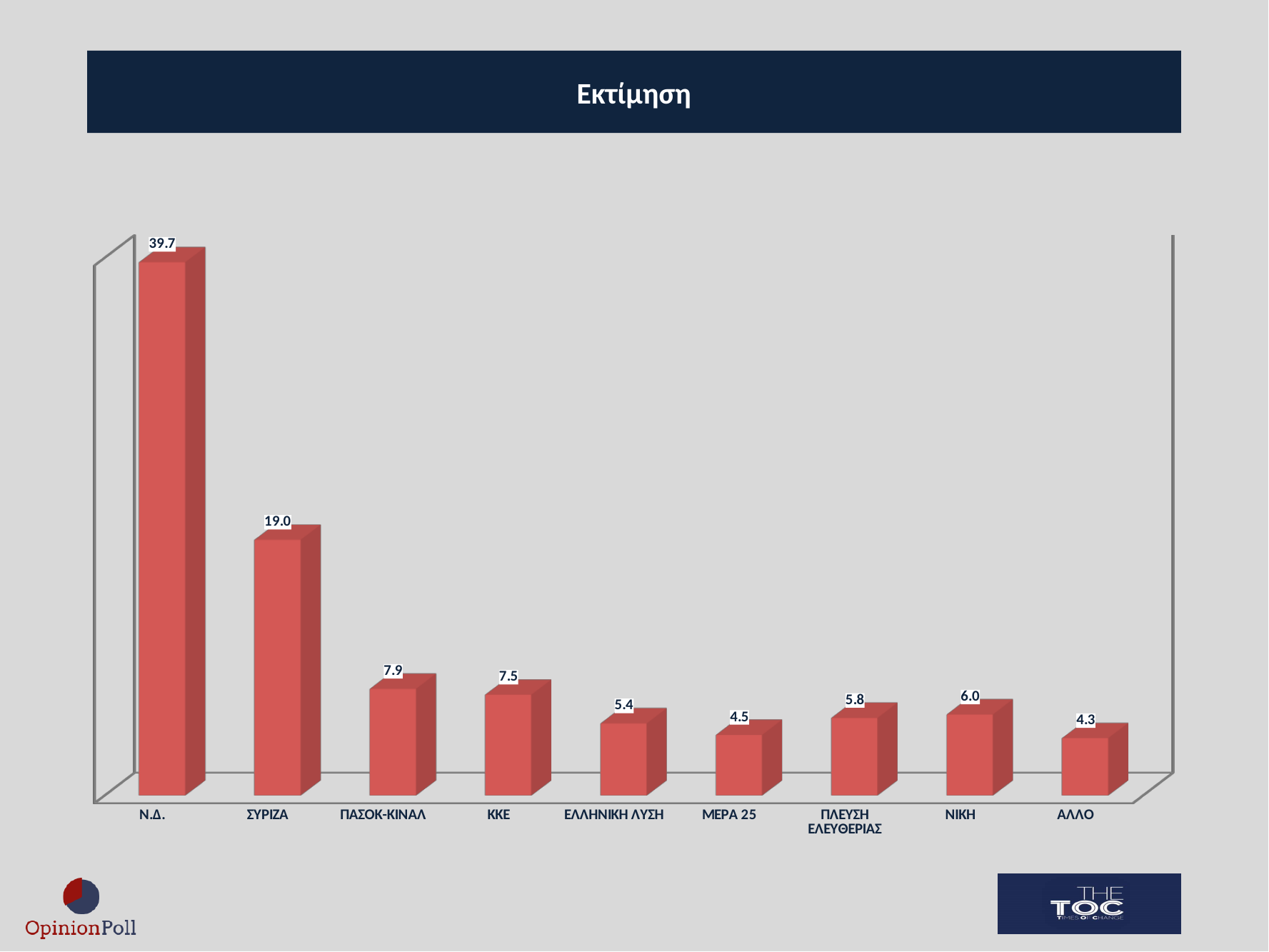
What is the difference between the values for ΠΑΣΟΚ-ΚΙΝΑΛ and ΚΚΕ? 0.4 How many categories are shown on the chart? 9 What is the value for ΑΛΛΟ? 4.3 Which category has the lowest value? ΑΛΛΟ What kind of chart is shown on the slide? Bar chart What is the value for Ν.Δ.? 39.7 What is the title of the chart? Εκτίμηση What is the difference between the values for Ν.Δ. and ΣΥΡΙΖΑ? 20.7 What is the value for ΠΛΕΥΣΗ ΕΛΕΥΘΕΡΙΑΣ? 5.8 What is the value for ΣΥΡΙΖΑ? 19.0 Which has a larger value, ΝΙΚΗ or ΕΛΛΗΝΙΚΗ ΛΥΣΗ? ΝΙΚΗ Which category has the highest value? Ν.Δ.